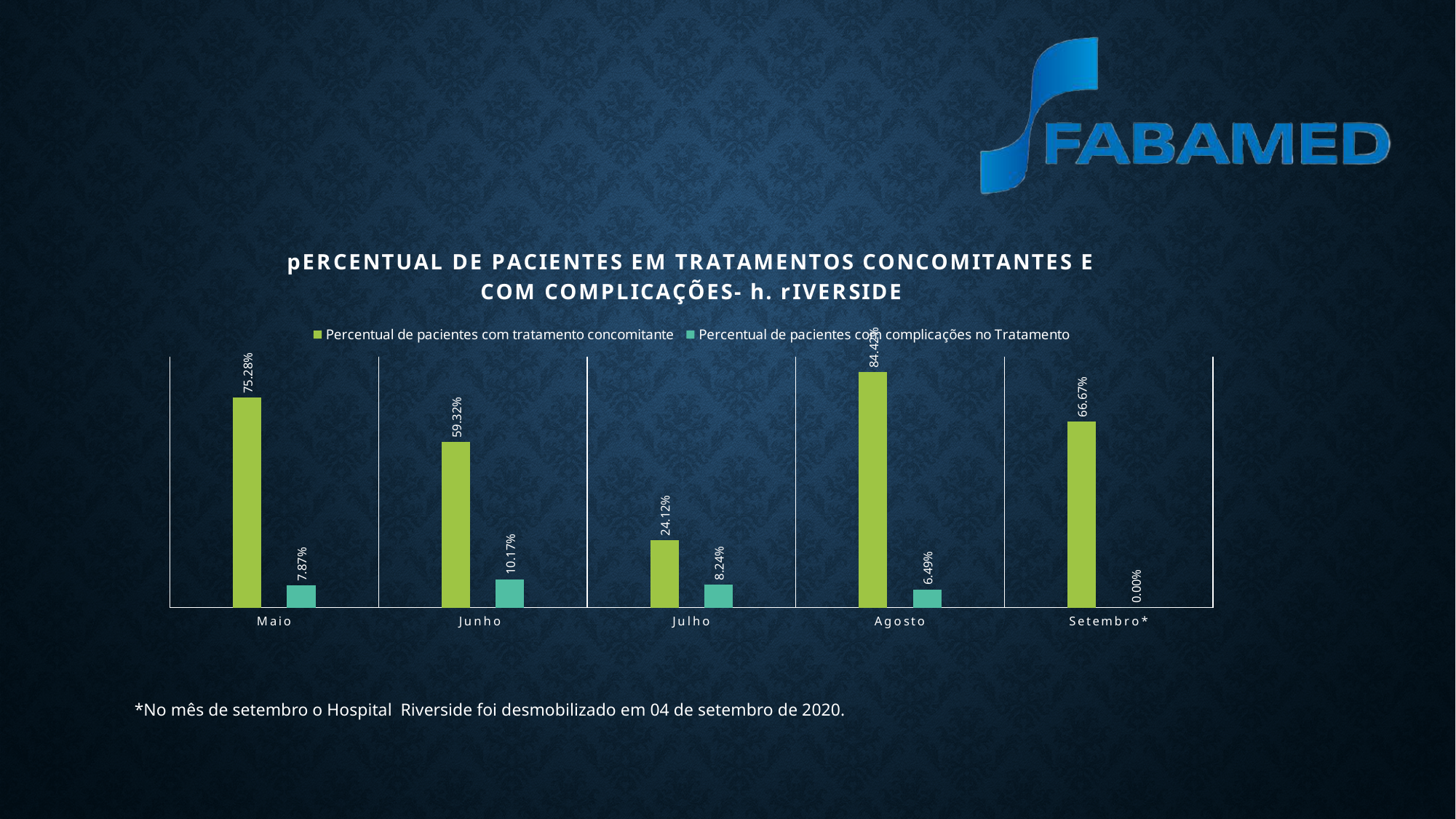
How many series does the legend list? 2 Which month has the highest percentage of patients with concomitant treatment? Agosto Which month has the lowest percentage of patients with concomitant treatment? Julho What is the difference between the percentage of patients with concomitant treatment in Maio and in Junho? 15.96% Which month has the highest percentage of patients with complications in treatment? Junho What is the percentage of patients with complications in treatment in Setembro*? 0.00% What is the percentage of patients with concomitant treatment in Julho? 24.12% What type of chart is shown on the slide? bar chart What is the percentage of patients with complications in treatment (Percentual de pacientes com complicações no Tratamento) in Junho? 10.17% Which is larger: the percentage of patients with complications in treatment in Maio or in Julho? Julho What is the percentage of patients with concomitant treatment (Percentual de pacientes com tratamento concomitante) in Maio? 75.28% How many months are shown on the x axis? 5